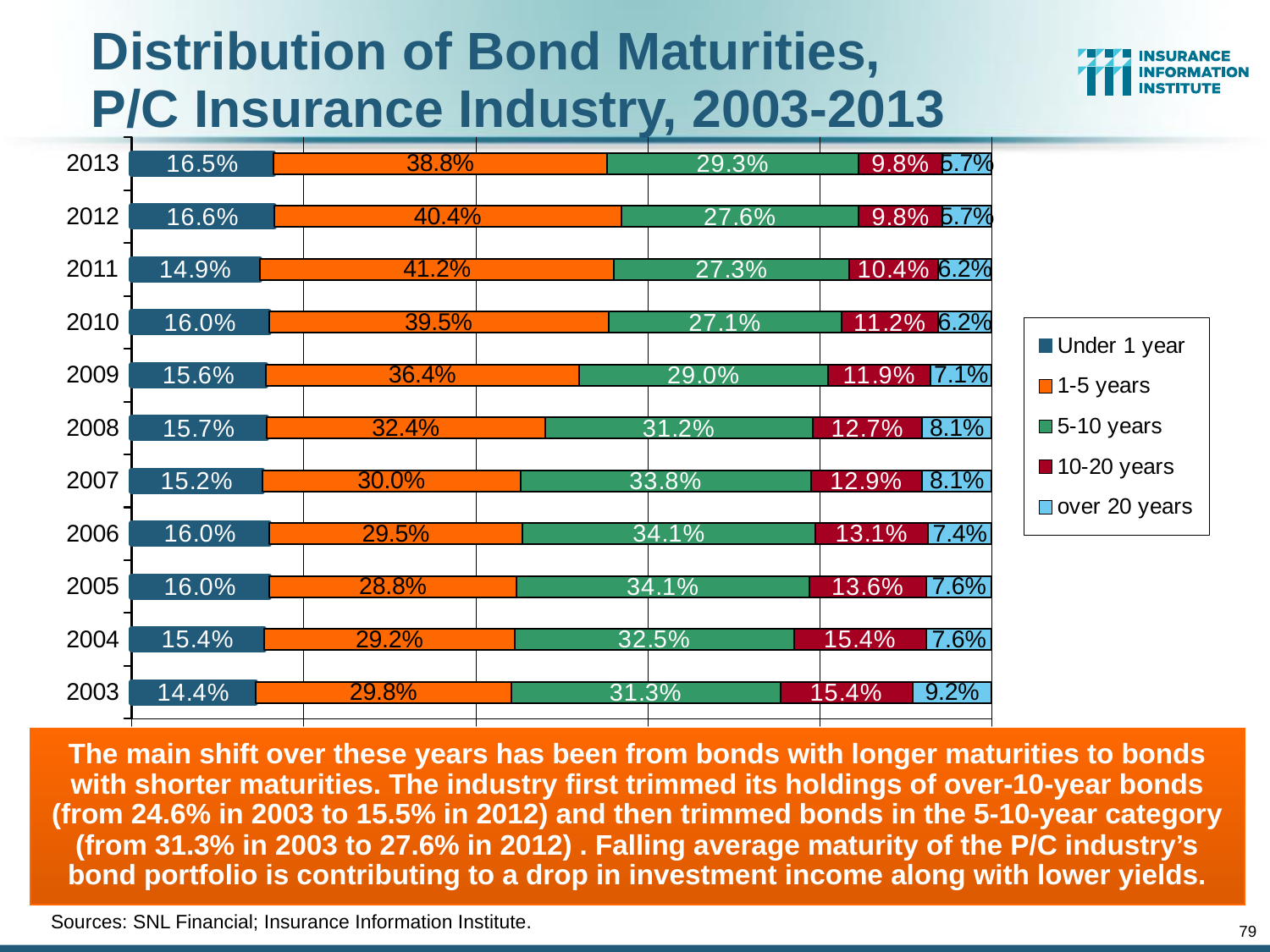
What kind of chart is shown on the slide? Stacked bar chart What was the 5-10 years share in 2006? 34.1% In which year was the Under 1 year share the lowest? 2003 What share of bonds had maturities of 1-5 years in 2011? 41.2% Which year had a larger 5-10 years share, 2007 or 2008? 2007 How many years are shown on the chart? 11 How many maturity categories does the legend list? 5 What was the 10-20 years share in 2003? 15.4% What was the over 20 years share in 2003? 9.2% Did the 10-20 years share rise or fall from 2003 to 2013? Fall By how many percentage points did the 10-20 years share fall from 2003 to 2013? 5.6 percentage points In which year was the 1-5 years share the highest? 2011